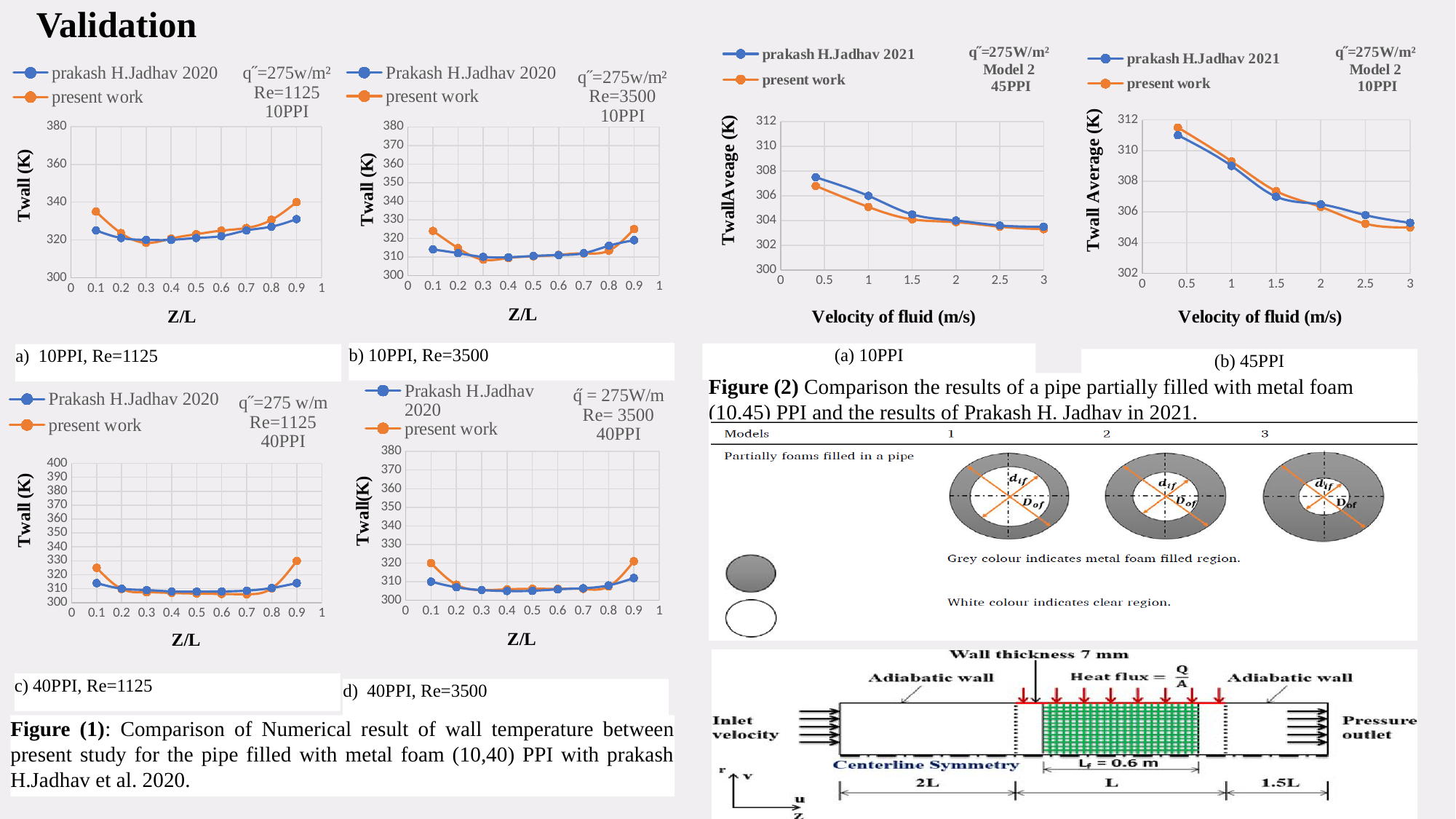
In the chart labelled a) 10PPI, Re=1125, how many series does the legend list? 2 In the chart labelled d) 40PPI, Re=3500, is the present work value at Z/L = 0.9 greater or less than 310? greater In the chart labelled a) 10PPI, Re=1125, is the present work value at Z/L = 0.1 greater or less than 320? greater In the chart labelled a) 10PPI, Re=1125, what kind of chart is shown? line chart In the chart labelled a) 10PPI, Re=1125, how many data points are plotted for the present work series? 9 In the chart labelled c) 40PPI, Re=1125, is the present work value at Z/L = 0.9 greater or less than 320? greater In the Figure (2) chart labelled (a) 10PPI, how many data points are plotted for the present work series? 6 In the Figure (2) chart labelled (b) 45PPI, what is the x-axis title? Velocity of fluid (m/s) In the Figure (2) chart labelled (b) 45PPI, what are the two legend entries? prakash H.Jadhav 2021 and present work In the Figure (2) chart labelled (a) 10PPI, do the values rise or fall as the velocity of fluid increases? fall